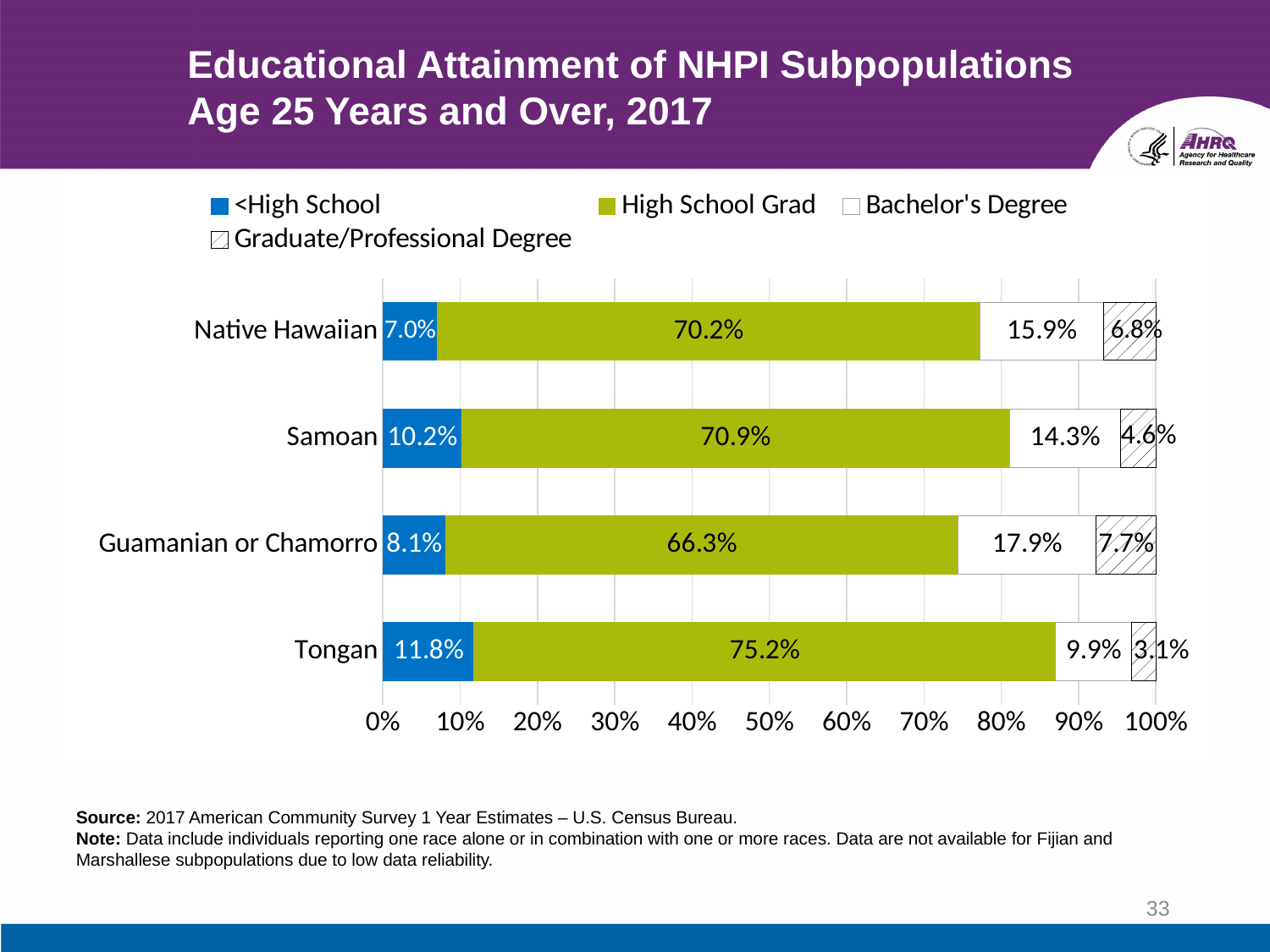
What is the Bachelor's Degree value for Guamanian or Chamorro? 17.9% Which subpopulation has the highest <High School percentage? Tongan What is the difference between the High School Grad values for Tongan and Guamanian or Chamorro? 8.9% Which series is shown in green on the chart? High School Grad What kind of chart is shown on the slide? Stacked bar chart What percentage of Tongans age 25 and over are High School Grads? 75.2% Which is larger, the Bachelor's Degree value for Native Hawaiian or for Samoan? Native Hawaiian Which subpopulation has the lowest Graduate/Professional Degree percentage? Tongan What is the total of the stacked bar for Native Hawaiian? 99.9% How many subpopulations are shown on the chart? 4 How many series does the legend list? 4 What is the Graduate/Professional Degree value for Samoan? 4.6%